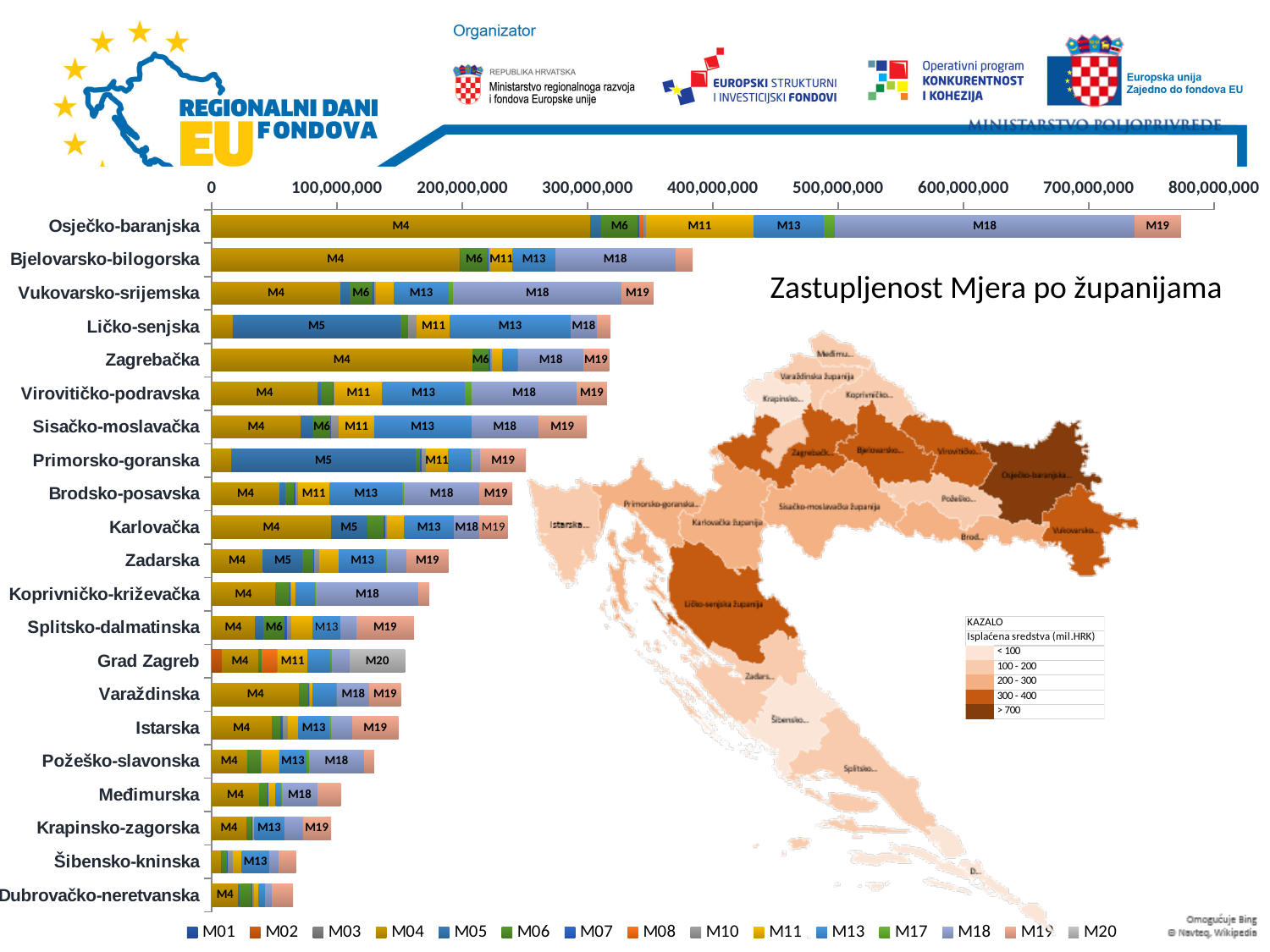
Is the total value for Grad Zagreb greater or less than 100,000,000? greater Which county has the longest total bar in the chart? Osječko-baranjska What is the title of the bar chart? Zastupljenost Mjera po županijama How many series does the legend of the bar chart list? 15 Is the total value for Osječko-baranjska greater or less than 700,000,000? greater Is the total value for Ličko-senjska greater or less than 300,000,000? greater Do the total bar lengths rise or fall going from the top county to the bottom county? fall Which measure forms the largest segment of the Osječko-baranjska bar? M4 Which has a larger total bar, Zagrebačka or Zadarska? Zagrebačka What kind of chart is used to show the representation of measures by county? Stacked bar chart How many counties (categories) are shown in the bar chart? 21